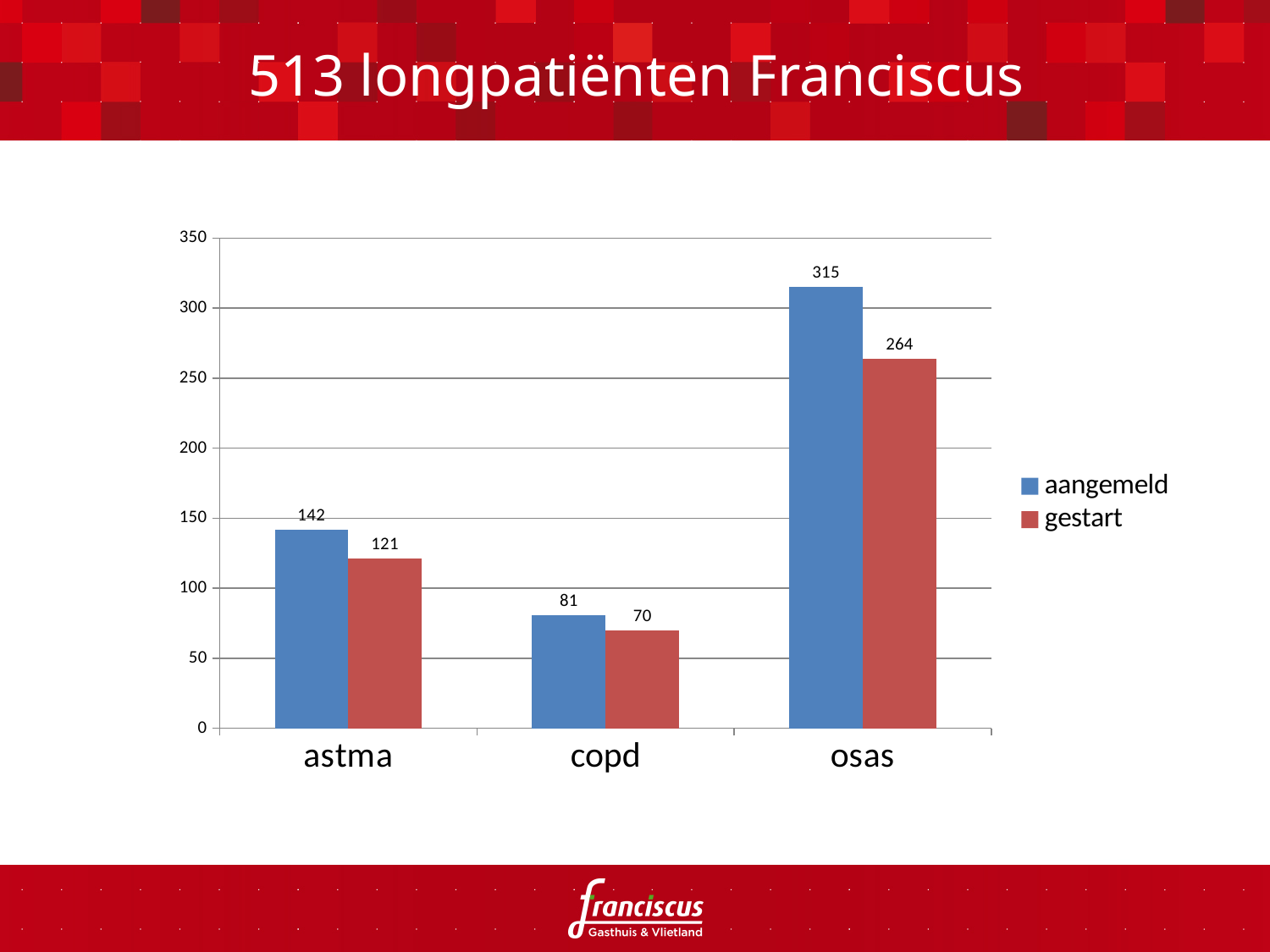
What is the 'gestart' value for copd? 70 How many series does the legend list? 2 Which category has the lowest 'gestart' value? copd What kind of chart is shown on the slide? bar chart How many categories are shown on the x axis? 3 What is the difference between 'aangemeld' and 'gestart' for osas? 51 Which is larger: the 'gestart' value for astma or the 'aangemeld' value for copd? gestart for astma What is the 'aangemeld' value for astma? 142 What is the difference between the 'aangemeld' values for astma and copd? 61 What is the 'gestart' value for osas? 264 Which category has the highest 'aangemeld' value? osas Is the 'aangemeld' value for osas greater or less than 300? greater